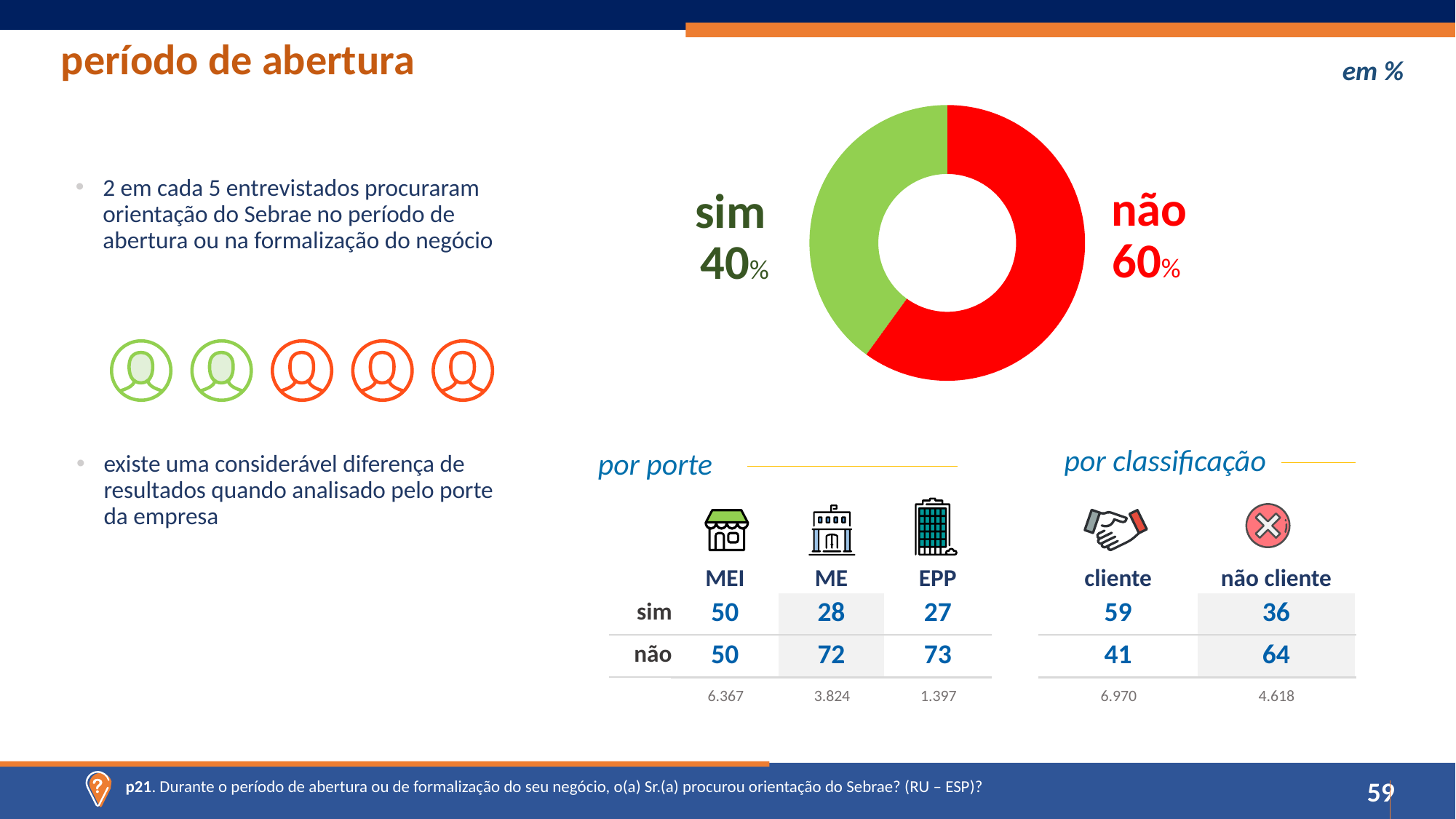
What share of the donut chart does the "sim" slice represent? 40% Which slice of the donut chart is the largest? não In the donut chart, what percentage of respondents answered "sim"? 40% Which slice of the donut chart is the smallest? sim Is the "não" share in the donut chart greater or less than 50%? greater In the donut chart, what percentage of respondents answered "não"? 60% What is the difference between the "não" and "sim" percentages in the donut chart? 20% In the donut chart, which is larger: "sim" or "não"? não In the "por porte" table, what is the "sim" value for ME? 28 How many slices does the donut chart have? 2 What kind of chart is shown at the top of the slide? donut (pie) chart What colour is the "não" slice in the donut chart? red